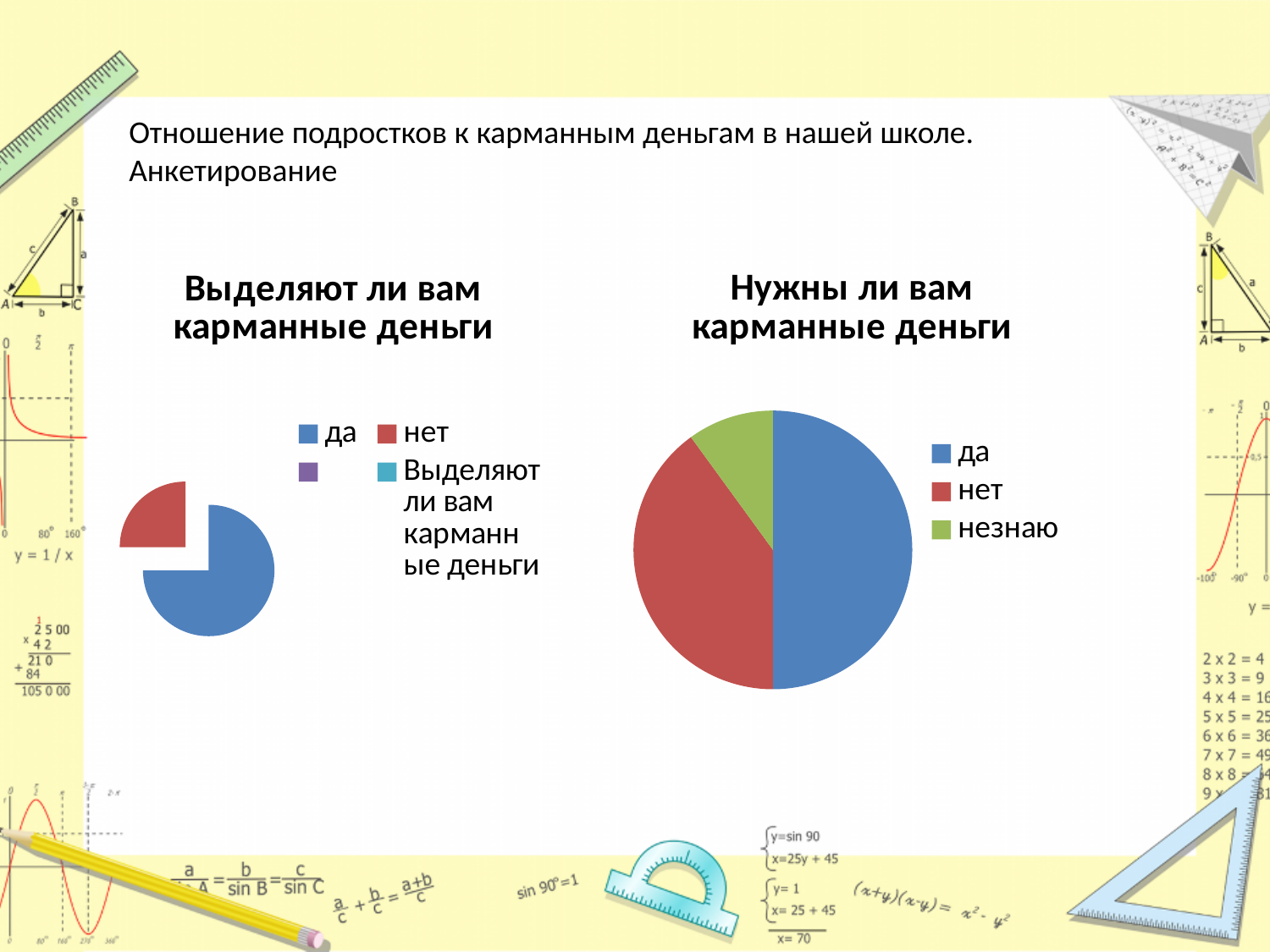
In the chart titled "Нужны ли вам карманные деньги", which category has the largest slice? да In the chart titled "Нужны ли вам карманные деньги", which slice is larger, "нет" or "незнаю"? нет How many visible slices does the pie in the chart titled "Нужны ли вам карманные деньги" have? 3 What kind of chart is the chart titled "Выделяют ли вам карманные деньги"? pie chart How many entries does the legend of the chart titled "Нужны ли вам карманные деньги" list? 3 In the chart titled "Выделяют ли вам карманные деньги", which slice is larger, "да" or "нет"? да How many visible slices does the pie in the chart titled "Выделяют ли вам карманные деньги" have? 2 In the chart titled "Выделяют ли вам карманные деньги", which category has the largest slice? да In the chart titled "Нужны ли вам карманные деньги", what colour is the "незнаю" slice? green What is the title of the pie chart on the left side of the slide? Выделяют ли вам карманные деньги In the chart titled "Нужны ли вам карманные деньги", which category has the smallest slice? незнаю What kind of chart is the chart titled "Нужны ли вам карманные деньги"? pie chart